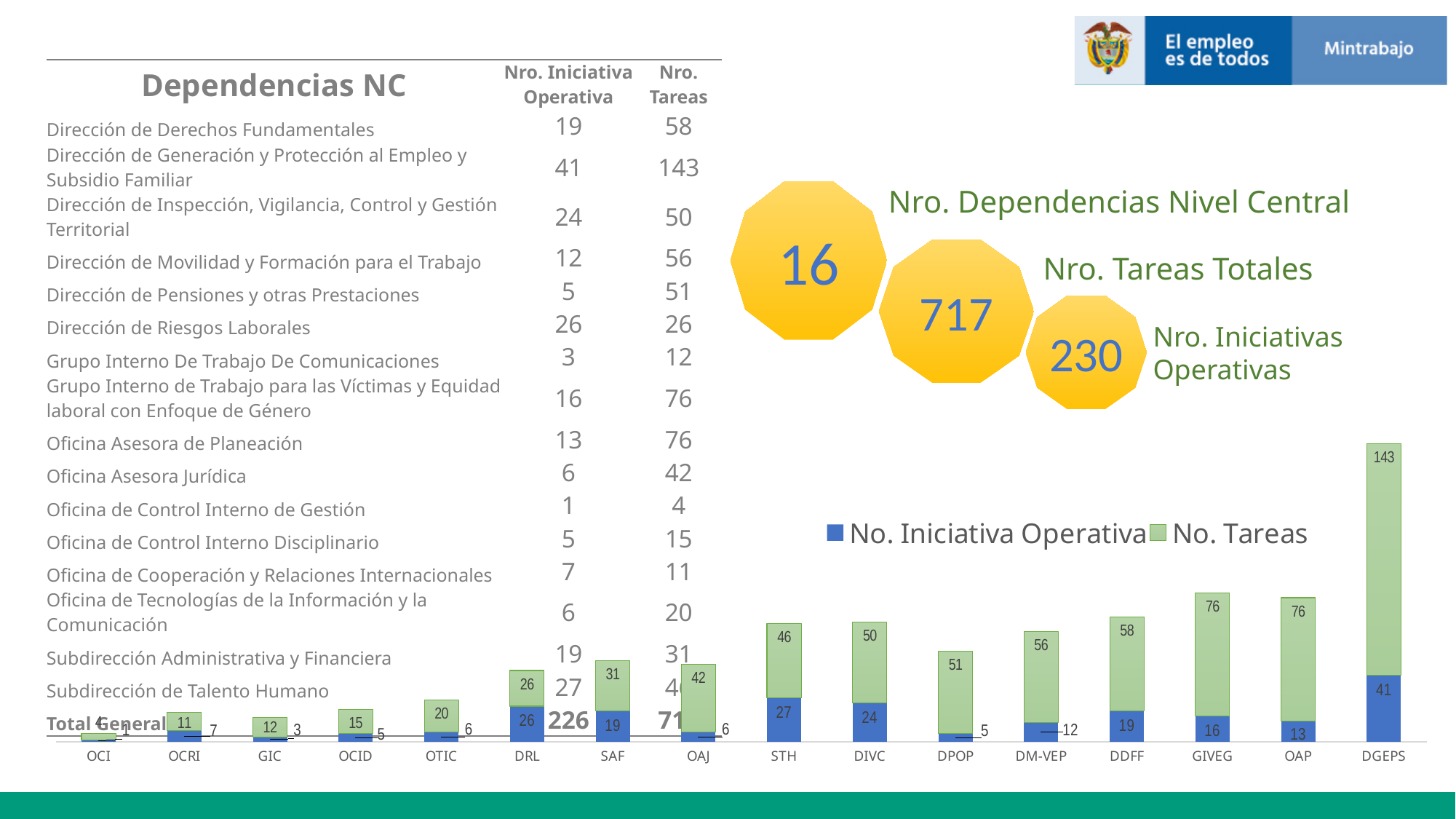
Which category has the highest No. Tareas value in the chart? DGEPS What is the No. Tareas value for DGEPS in the chart? 143 Which colour represents the No. Tareas series in the chart? Green How many categories (dependencias) are shown along the x axis of the chart? 16 Which category has the lowest No. Iniciativa Operativa value in the chart? OCI What is the No. Iniciativa Operativa value for STH in the chart? 27 Which has a larger No. Tareas value, GIVEG or DPOP? GIVEG What is the total of the stacked bar for DGEPS (No. Iniciativa Operativa plus No. Tareas)? 184 How many series does the chart legend list? 2 What is the difference between the No. Tareas values for DGEPS and OAP? 67 Do the No. Tareas values generally rise or fall moving from left to right along the x axis? Rise What type of chart is shown on the slide? Stacked bar chart